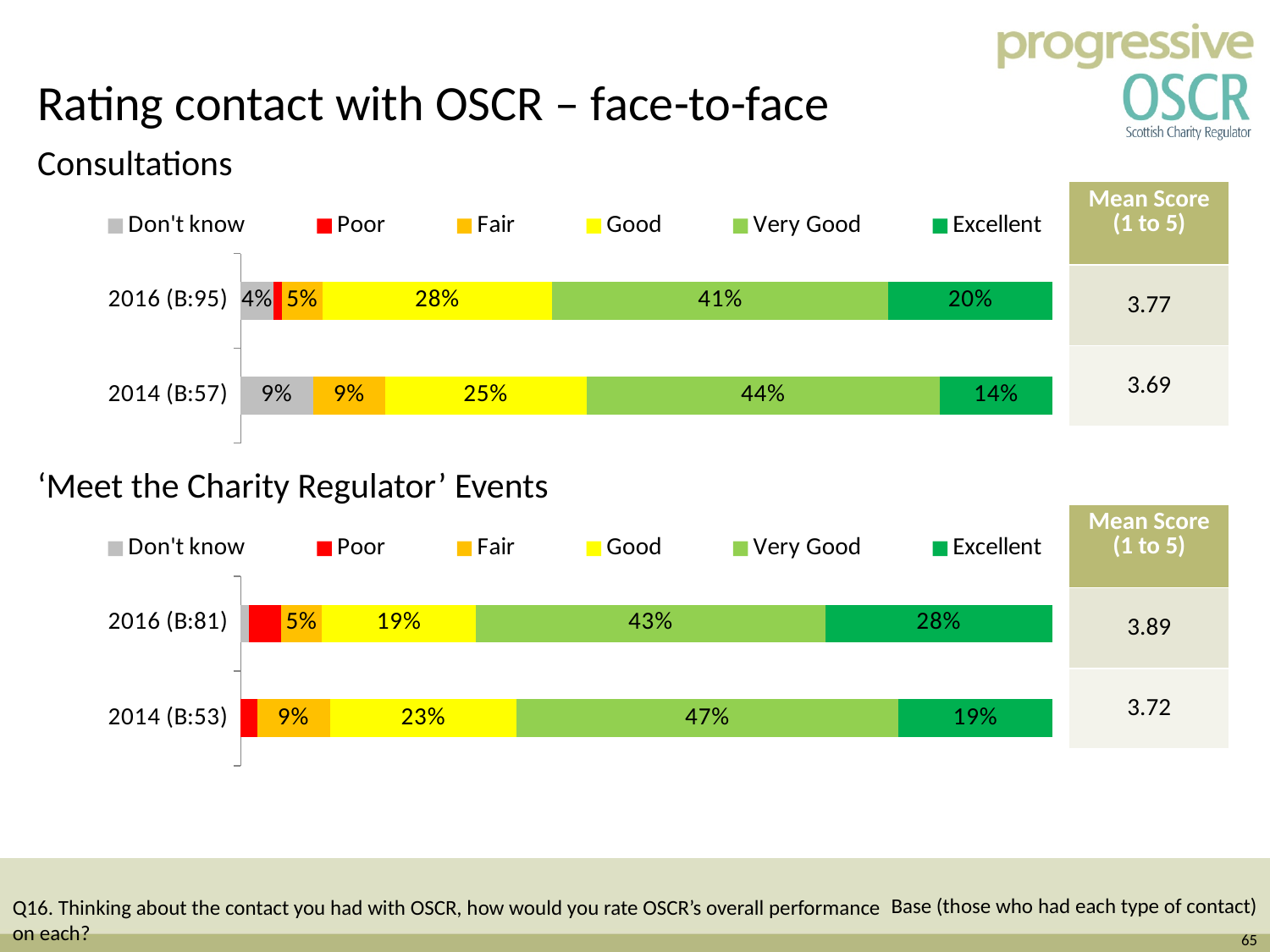
In the Consultations chart, what percentage rated contact as Excellent in 2014 (B:57)? 14% In the Consultations chart, what is the difference between the Very Good share in 2014 (44%) and in 2016 (41%)? 3 percentage points What type of chart is used for the 'Meet the Charity Regulator' Events data? Stacked bar chart How many years (bars) are shown in the Consultations chart? 2 In the 'Meet the Charity Regulator' Events chart, what percentage rated the events as Excellent in 2016 (B:81)? 28% In the 'Meet the Charity Regulator' Events chart, which year has the larger Fair share, 2016 or 2014? 2014 In the 'Meet the Charity Regulator' Events chart, which rating has the largest share in 2014 (B:53)? Very Good In the Consultations chart, what percentage rated contact as Very Good in 2016 (B:95)? 41% In the 'Meet the Charity Regulator' Events chart, by how many percentage points did the Excellent share rise from 2014 to 2016? 9 percentage points In the 'Meet the Charity Regulator' Events chart, what percentage rated the events as Very Good in 2014 (B:53)? 47% How many series does the legend of the Consultations chart list? 6 In the Consultations chart, which year has the larger Good share, 2016 or 2014? 2016